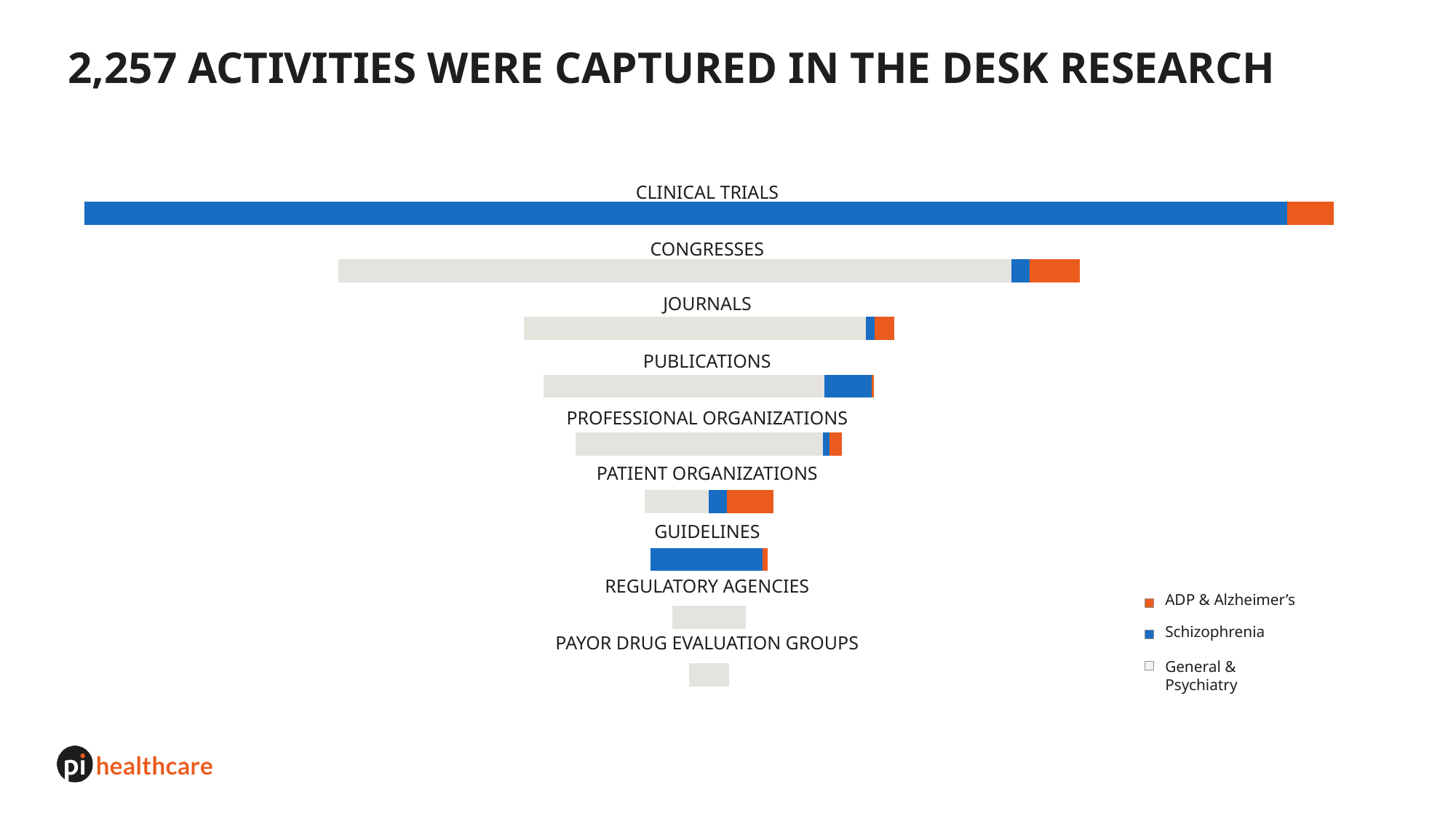
Which series is shown in orange in the legend? ADP & Alzheimer's Which category has the longest bar in the chart? Clinical Trials Do the bar lengths increase or decrease from the top category to the bottom category? Decrease Which bar is longer, Clinical Trials or Congresses? Clinical Trials Which bar is longer, Patient Organizations or Regulatory Agencies? Patient Organizations What is the title of the slide? 2,257 ACTIVITIES WERE CAPTURED IN THE DESK RESEARCH Which bar is longer, Journals or Guidelines? Journals What kind of chart is shown on the slide? Stacked bar chart Which category has the shortest bar in the chart? Payor Drug Evaluation Groups How many series does the legend list? 3 How many activity categories are shown in the chart? 9